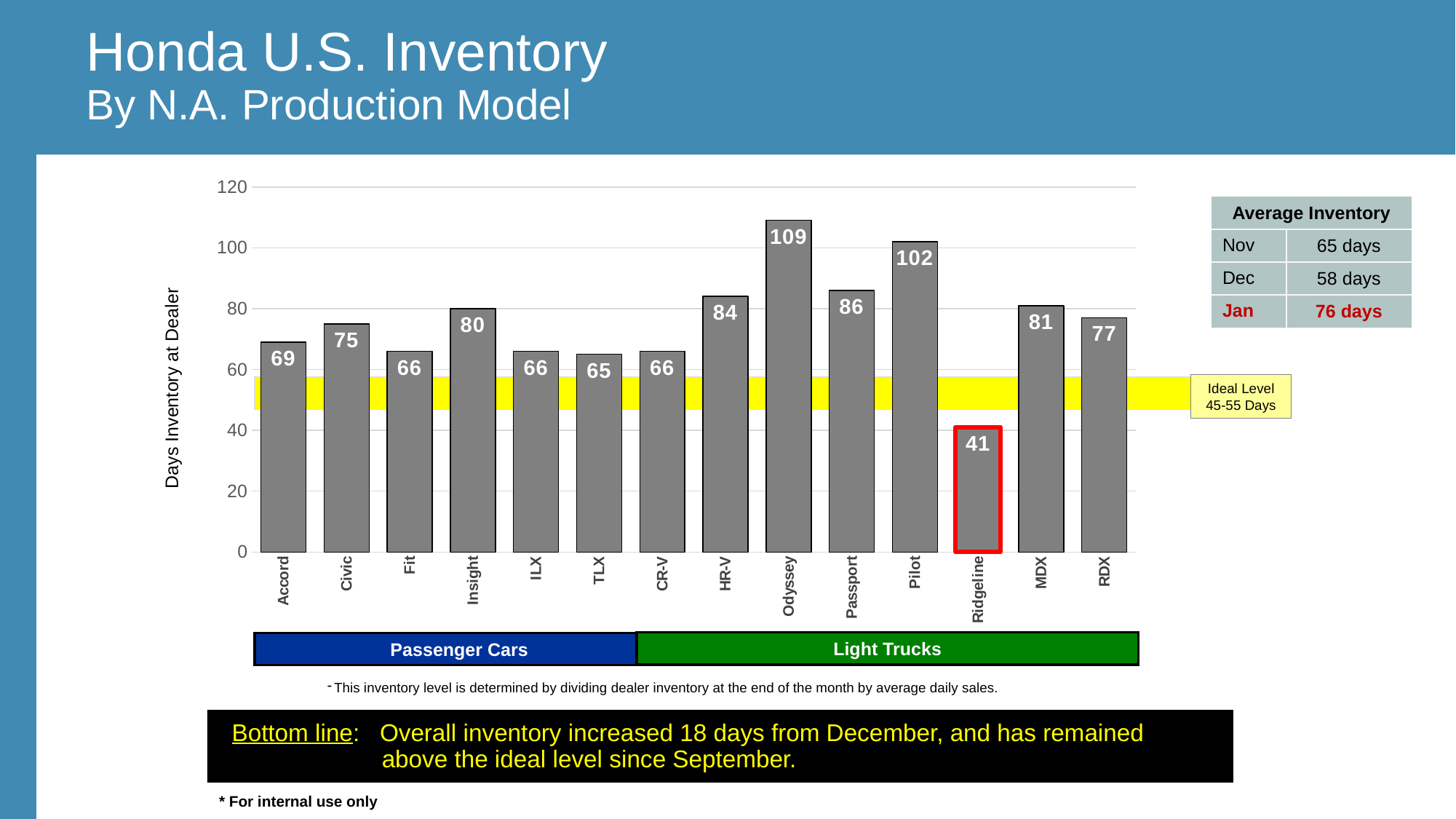
Which has a higher days inventory, the MDX or the RDX? MDX What kind of chart is shown on the slide? Bar chart What is the days inventory at dealer for the Ridgeline? 41 How many models are shown on the chart? 14 What is the label on the vertical axis of the chart? Days Inventory at Dealer What is the days inventory at dealer for the Odyssey? 109 What is the difference in days inventory between the Pilot and the Passport? 16 What range does the yellow band on the chart mark as the ideal level? 45-55 Days Is the value for the HR-V greater or less than 80? greater What is the days inventory at dealer for the Accord? 69 Which model has the lowest days inventory at dealer? Ridgeline Which model has the highest days inventory at dealer? Odyssey